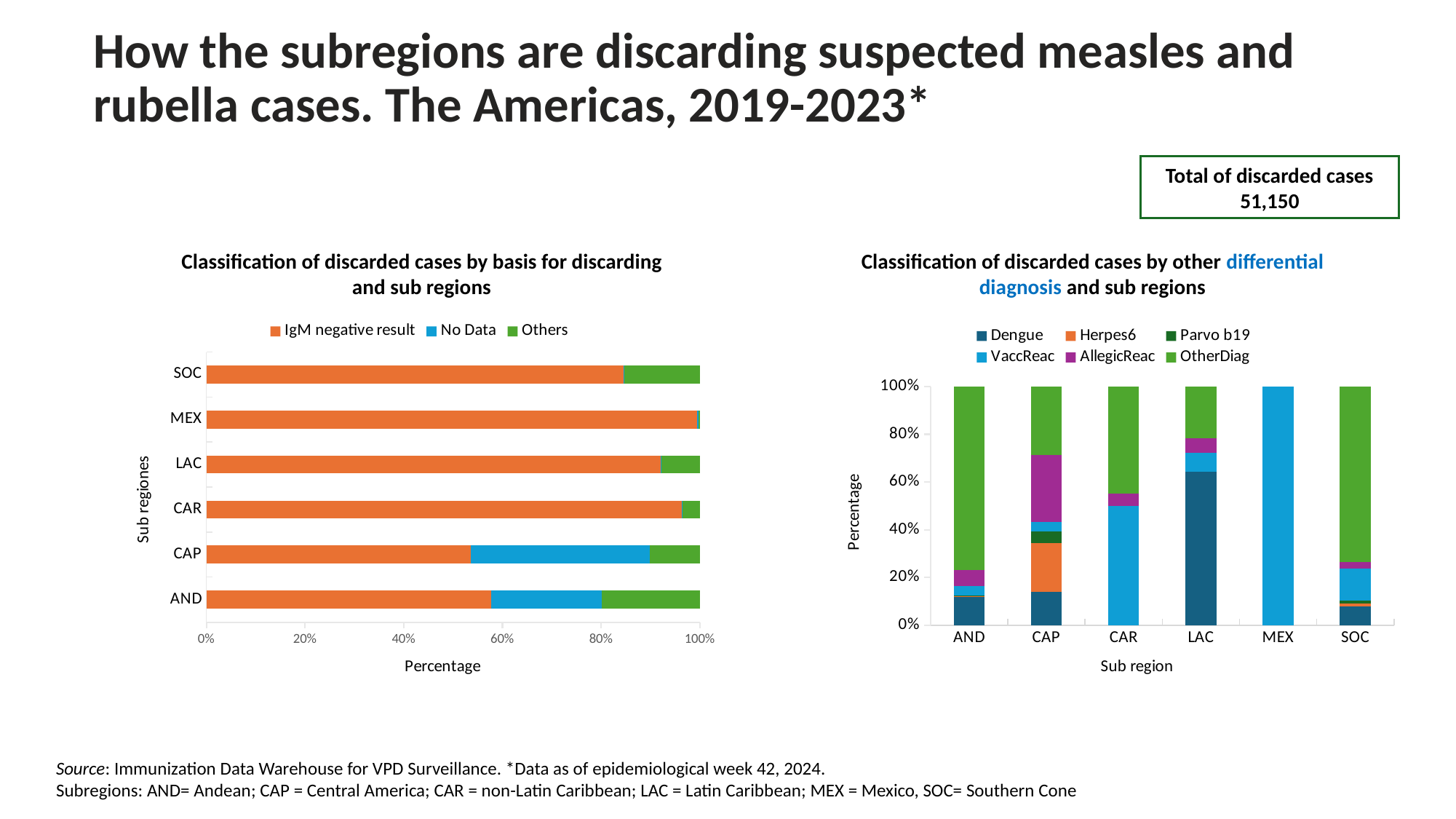
In the 'Classification of discarded cases by other differential diagnosis and sub regions' chart, which subregion has the largest Dengue share? LAC How many series does the legend of the 'Classification of discarded cases by basis for discarding and sub regions' chart list? 3 In the 'Classification of discarded cases by other differential diagnosis and sub regions' chart, is the Dengue share larger for LAC or for CAP? LAC What total of discarded cases is shown in the box on the slide? 51,150 In the 'Classification of discarded cases by basis for discarding and sub regions' chart, which subregion has the largest No Data share? CAP How many series does the legend of the 'Classification of discarded cases by other differential diagnosis and sub regions' chart list? 6 In the 'Classification of discarded cases by other differential diagnosis and sub regions' chart, is the Dengue share for LAC greater or less than 60%? greater How many subregions are shown on the x axis of the 'Classification of discarded cases by other differential diagnosis and sub regions' chart? 6 In the 'Classification of discarded cases by basis for discarding and sub regions' chart, is the No Data share for CAP greater or less than 20%? greater What kind of chart is the 'Classification of discarded cases by basis for discarding and sub regions' chart? Stacked bar chart In the 'Classification of discarded cases by other differential diagnosis and sub regions' chart, which subregion's bar is made up entirely of VaccReac? MEX In the 'Classification of discarded cases by basis for discarding and sub regions' chart, is the IgM negative result share for CAP greater or less than 60%? less